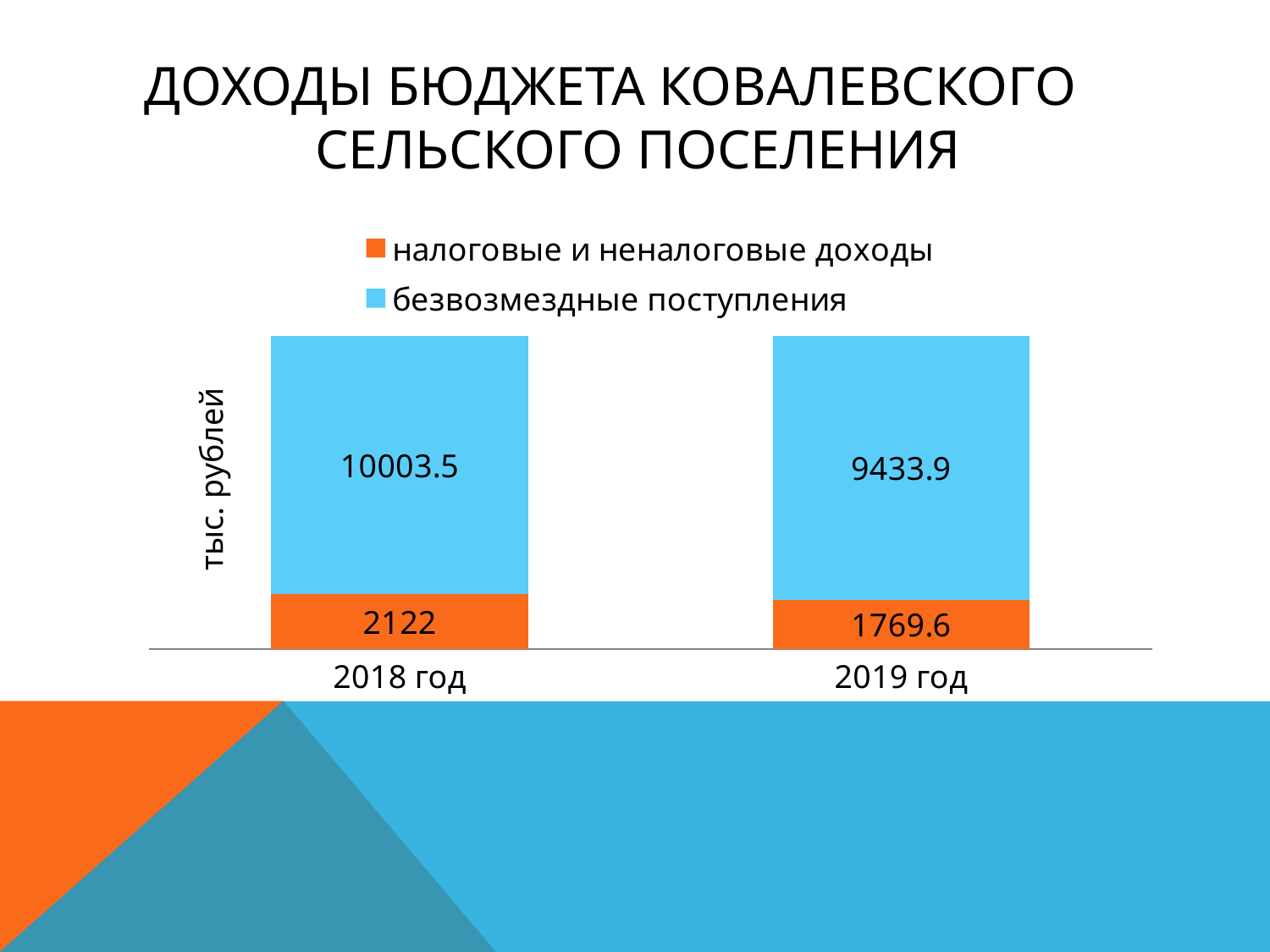
What is the total of the two labelled values in the 2018 год bar? 12125.5 Which year has the lower value for налоговые и неналоговые доходы? 2019 год What is the value of налоговые и неналоговые доходы for 2018 год? 2122 What is the difference between the налоговые и неналоговые доходы values for 2018 год and 2019 год? 352.4 What is the difference between the безвозмездные поступления values for 2018 год and 2019 год? 569.6 What is the value of безвозмездные поступления for 2019 год? 9433.9 Which year has the higher value for безвозмездные поступления? 2018 год How many series does the legend list? 2 What is the value of налоговые и неналоговые доходы for 2019 год? 1769.6 What is the total of the two labelled values in the 2019 год bar? 11203.5 What kind of chart is shown on the slide? Stacked bar chart What is the value of безвозмездные поступления for 2018 год? 10003.5